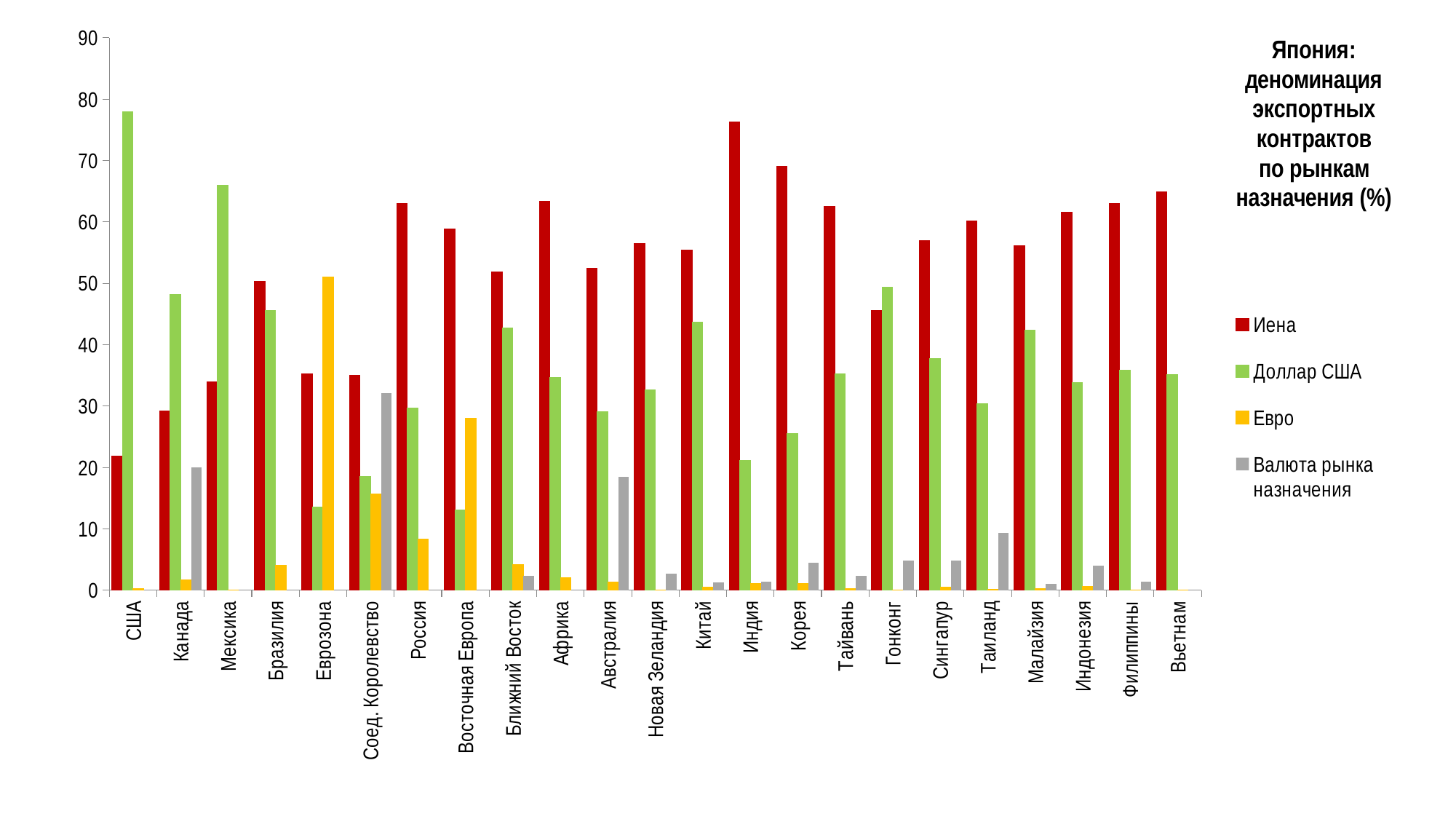
Which destination market has the lowest value for Иена? США Which destination market has the highest value for Иена? Индия What kind of chart is shown on the slide? bar chart For Канада, which is larger: Иена or Доллар США? Доллар США For Россия, which is larger: Иена or Доллар США? Иена How many series does the legend list? 4 Which destination market has the highest value for Валюта рынка назначения? Соед. Королевство How many destination markets (categories) are shown on the x axis? 23 Which destination market has the highest value for Доллар США? США Is the Иена value for Индия greater or less than 70? greater Is the Доллар США value for Мексика greater or less than 60? greater